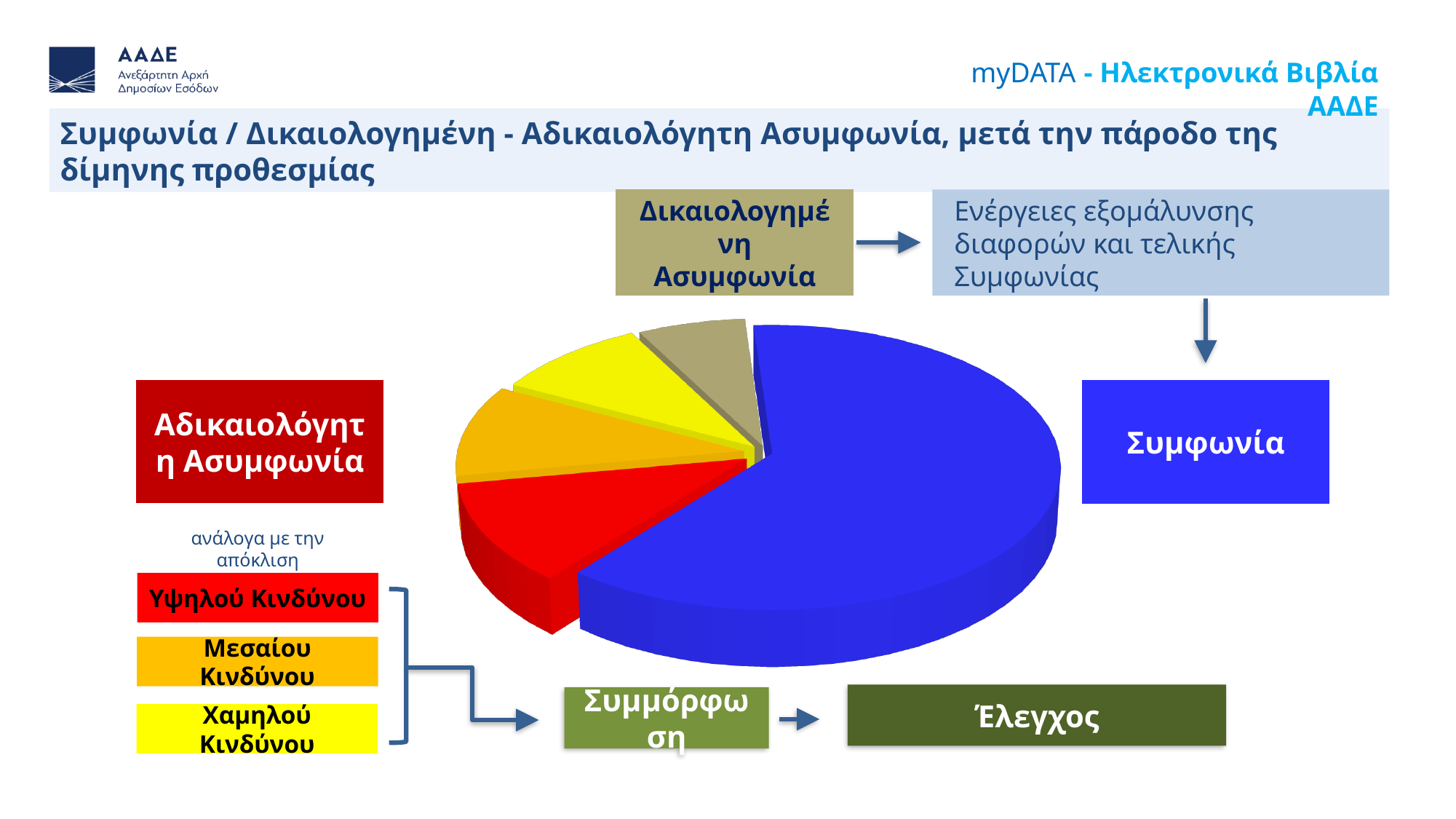
What colour is the slice representing Υψηλού Κινδύνου? red What colour is the slice representing Συμφωνία? blue Does the Συμφωνία slice take up more or less than half of the pie? more What kind of chart is shown on the slide? pie chart Which slice is larger, Υψηλού Κινδύνου (red) or Χαμηλού Κινδύνου (yellow)? Υψηλού Κινδύνου Which category has the largest slice of the pie chart? Συμφωνία Which slice is larger, Συμφωνία (blue) or Δικαιολογημένη Ασυμφωνία (khaki)? Συμφωνία Which slice is larger, Συμφωνία (blue) or Υψηλού Κινδύνου (red)? Συμφωνία How many slices does the pie chart have? 5